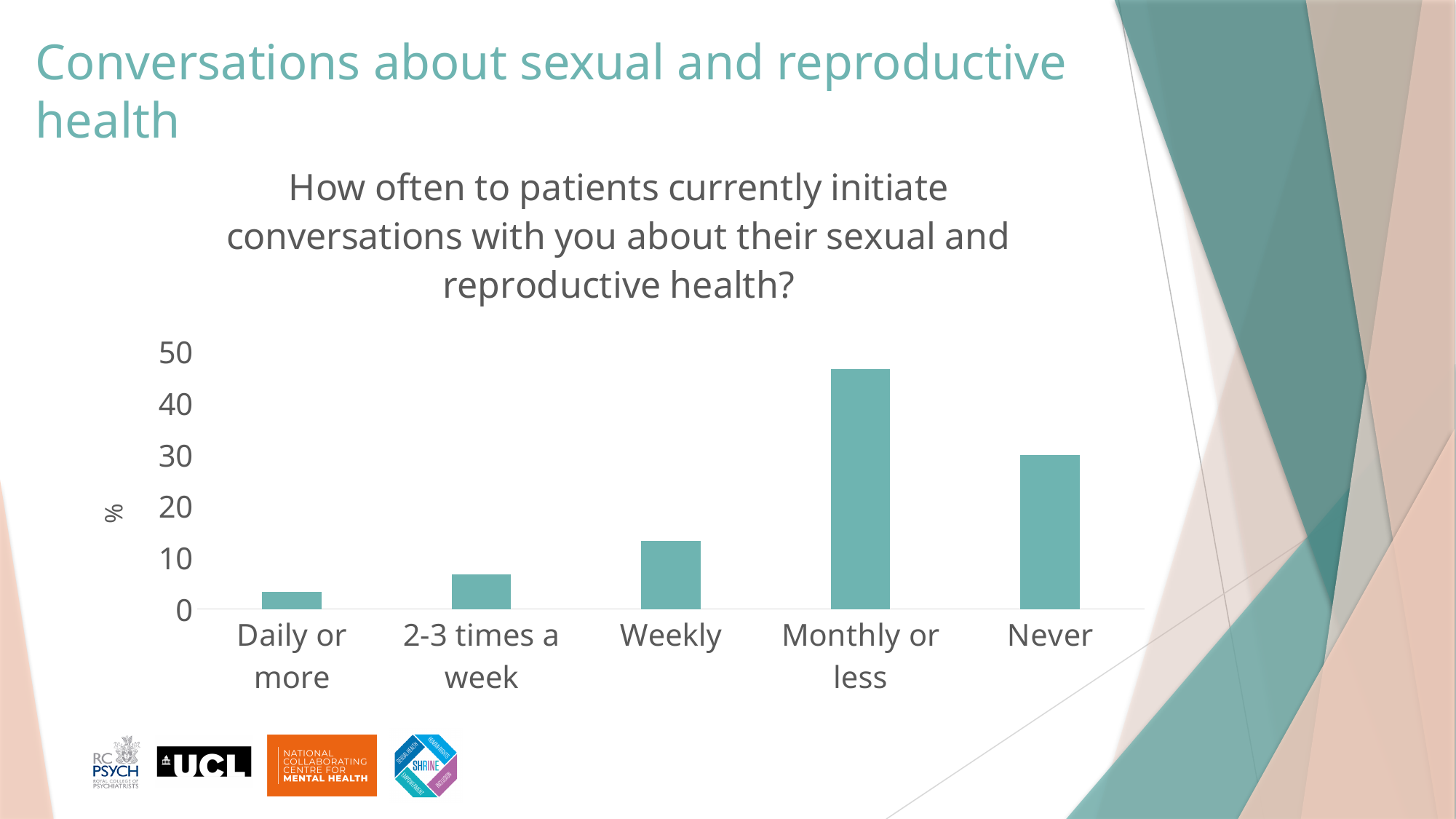
What is the label on the y axis of the chart? % What kind of chart is shown on the slide? bar chart Which is larger, the value for Never or the value for Weekly? Never Is the value for Monthly or less greater or less than 40? greater Is the value for 2-3 times a week greater or less than 10? less Is the value for Weekly greater or less than 20? less Which is larger, the value for 2-3 times a week or the value for Daily or more? 2-3 times a week Which category has the lowest bar in the chart? Daily or more Which category has the highest bar in the chart? Monthly or less How many categories are shown on the x axis of the chart? 5